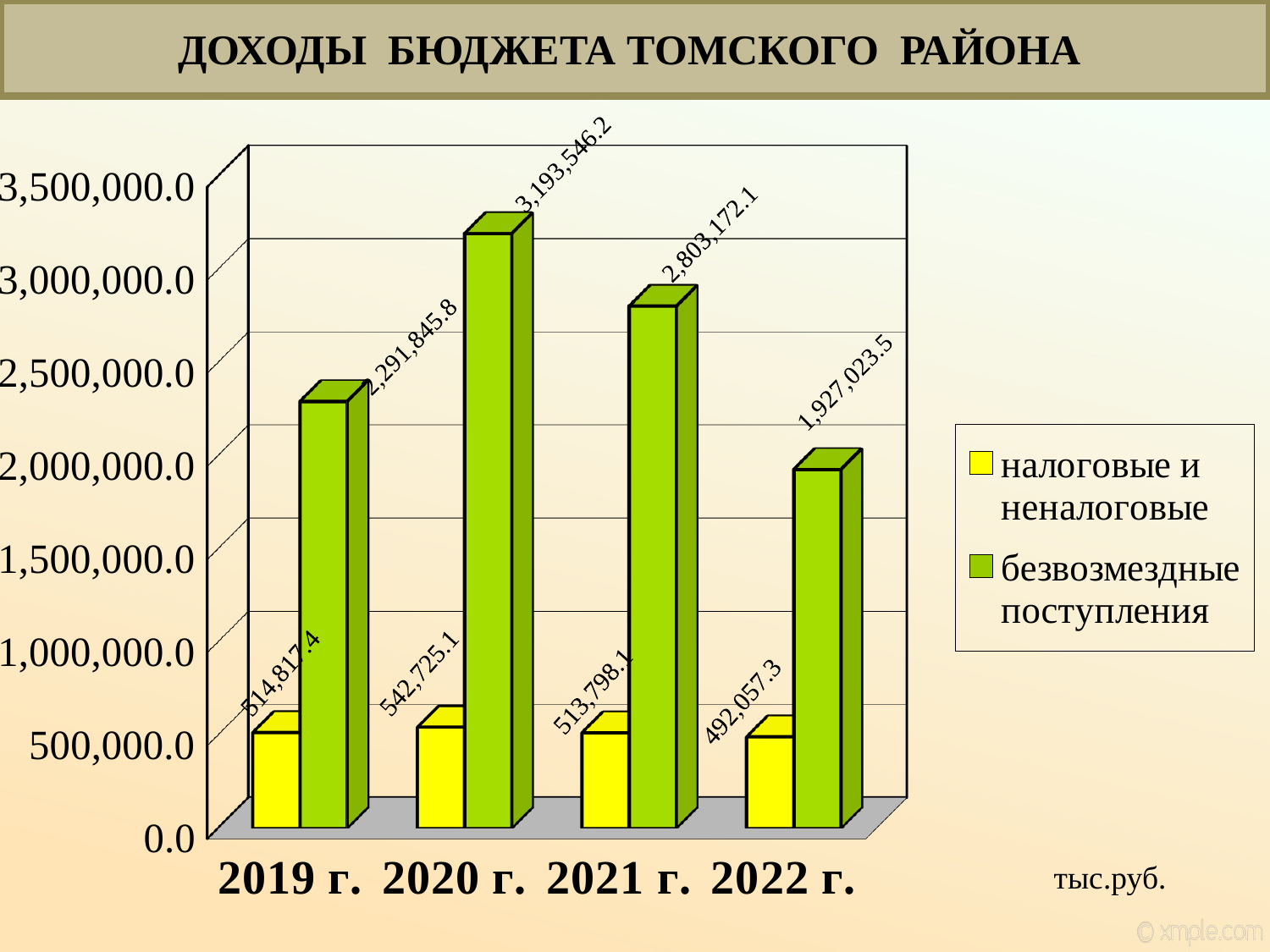
What is the value for безвозмездные поступления in 2020 г.? 3,193,546.2 What is the value for налоговые и неналоговые in 2019 г.? 514,817.4 How many years are shown on the x axis? 4 What is the difference between безвозмездные поступления in 2020 г. and in 2019 г.? 901,700.4 Which is larger: безвозмездные поступления in 2021 г. or in 2022 г.? 2021 г. Do the values for безвозмездные поступления rise or fall from 2020 г. to 2022 г.? Fall What kind of chart is shown on the slide? Bar chart What is the difference between налоговые и неналоговые in 2020 г. and in 2022 г.? 50,667.8 In which year is безвозмездные поступления highest? 2020 г. How many series does the legend list? 2 In which year is налоговые и неналоговые lowest? 2022 г. What is the value for безвозмездные поступления in 2022 г.? 1,927,023.5